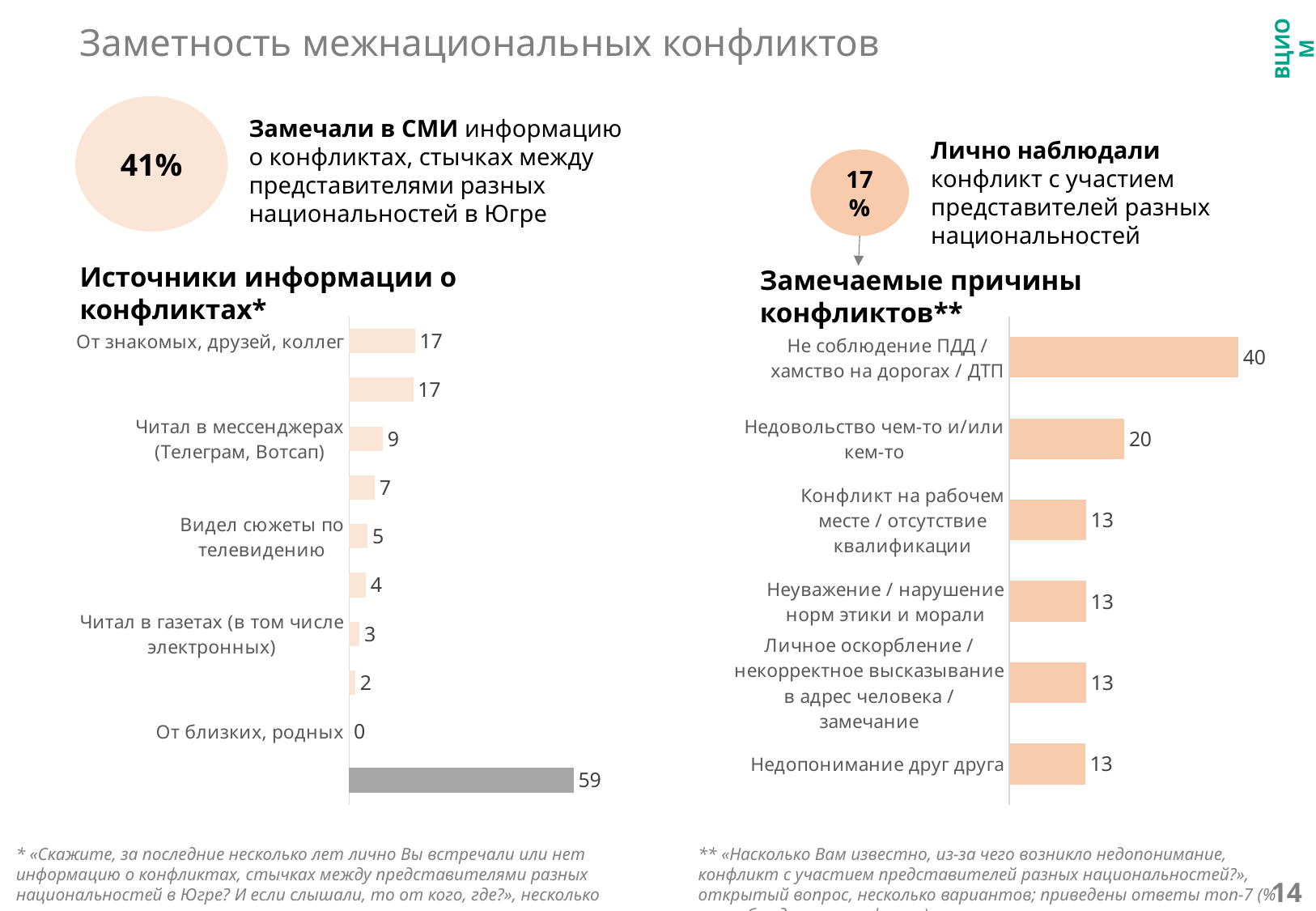
In the chart 'Замечаемые причины конфликтов**', how many categories are shown? 6 In the chart 'Замечаемые причины конфликтов**', which category has the highest value? Не соблюдение ПДД / хамство на дорогах / ДТП What type of chart is 'Замечаемые причины конфликтов**'? Bar chart In the chart 'Замечаемые причины конфликтов**', what is the value for 'Не соблюдение ПДД / хамство на дорогах / ДТП'? 40 In the chart 'Источники информации о конфликтах*', what is the value for 'От знакомых, друзей, коллег'? 17 In the chart 'Источники информации о конфликтах*', which is larger: 'Видел сюжеты по телевидению' or 'Читал в газетах (в том числе электронных)'? Видел сюжеты по телевидению In the chart 'Замечаемые причины конфликтов**', what is the value for 'Недопонимание друг друга'? 13 In the chart 'Замечаемые причины конфликтов**', what is the difference between 'Не соблюдение ПДД / хамство на дорогах / ДТП' and 'Недовольство чем-то и/или кем-то'? 20 In the chart 'Замечаемые причины конфликтов**', what is the value for 'Недовольство чем-то и/или кем-то'? 20 In the chart 'Источники информации о конфликтах*', what is the difference between 'От знакомых, друзей, коллег' and 'Читал в мессенджерах (Телеграм, Вотсап)'? 8 In the chart 'Источники информации о конфликтах*', what is the value for 'Читал в мессенджерах (Телеграм, Вотсап)'? 9 In the chart 'Источники информации о конфликтах*', what is the value for 'От близких, родных'? 0